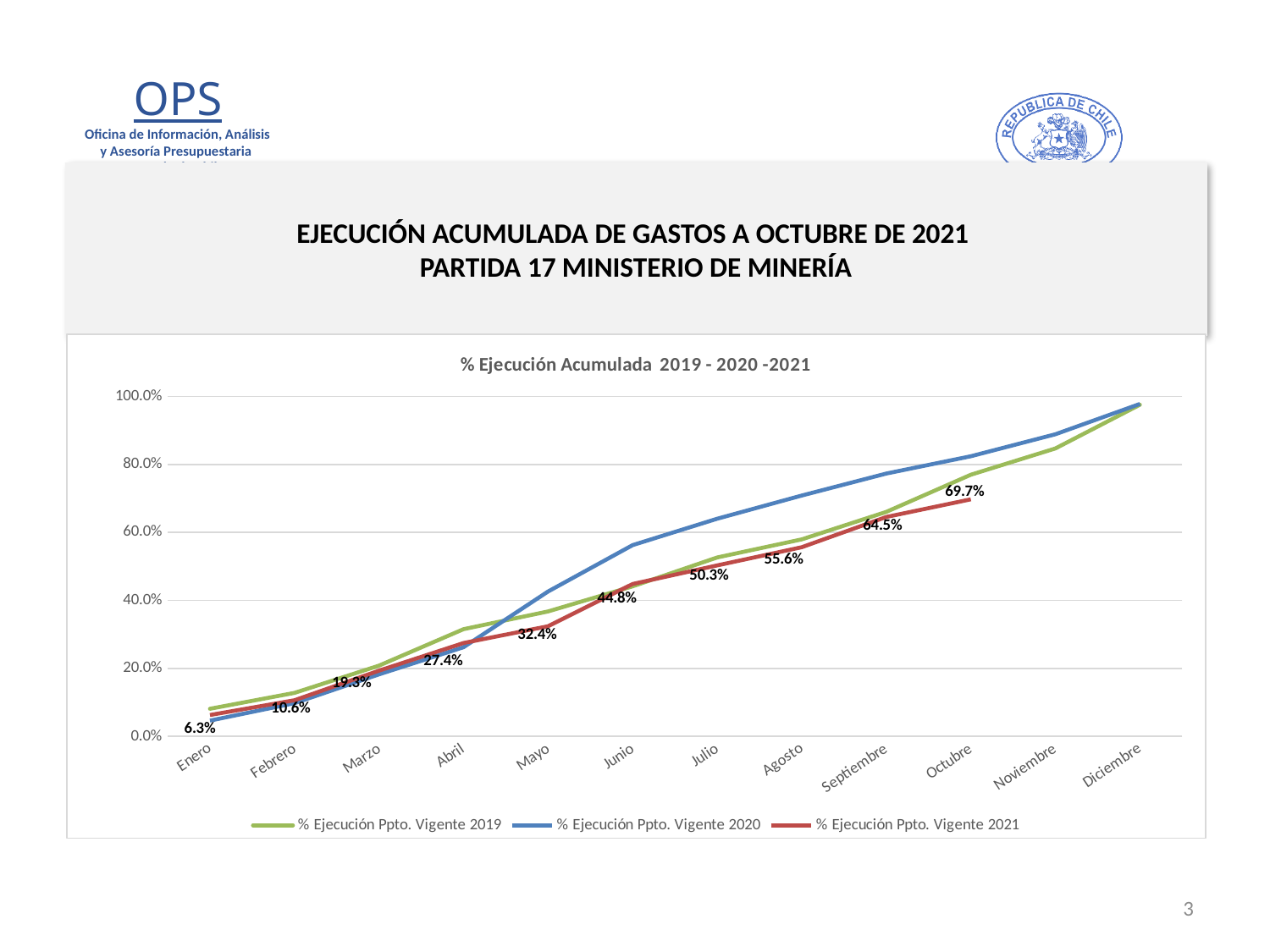
What is the difference between the % Ejecución Ppto. Vigente 2021 values for Junio and Mayo? 12.4% How many series does the legend list? 3 How many months are shown on the x axis? 12 What is the value for % Ejecución Ppto. Vigente 2021 in Junio? 44.8% Is the value for % Ejecución Ppto. Vigente 2020 in Julio greater or less than 60.0%? greater Which series has the higher value in Agosto, % Ejecución Ppto. Vigente 2020 or % Ejecución Ppto. Vigente 2021? % Ejecución Ppto. Vigente 2020 What is the title of the chart? % Ejecución Acumulada 2019 - 2020 -2021 What is the difference between the % Ejecución Ppto. Vigente 2021 values for Octubre and Septiembre? 5.2% What is the value for % Ejecución Ppto. Vigente 2021 in Octubre? 69.7% What is the value for % Ejecución Ppto. Vigente 2021 in Enero? 6.3% Does the % Ejecución Ppto. Vigente 2021 series rise or fall from Enero to Octubre? rise What type of chart is shown on the slide? line chart